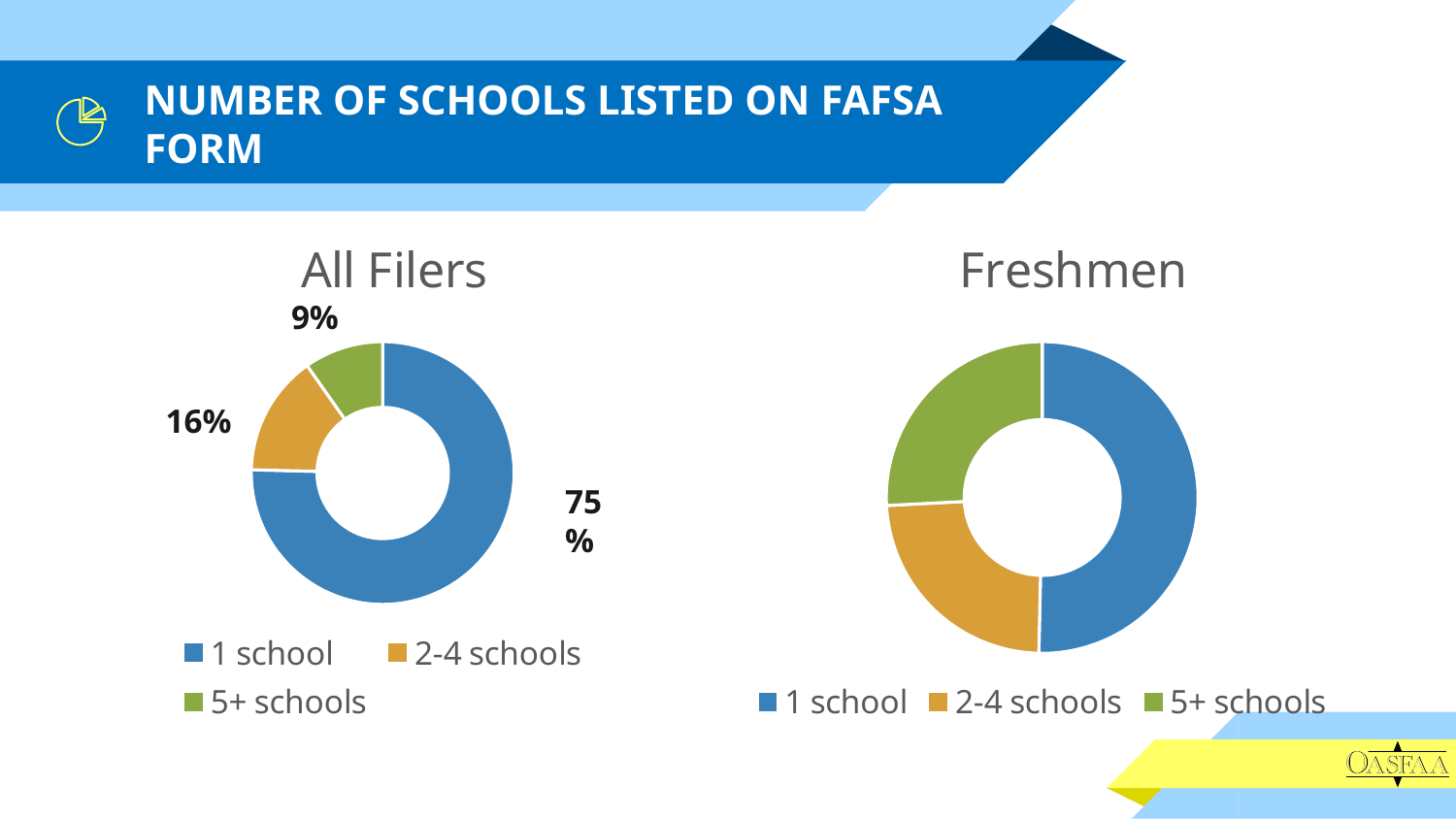
In the All Filers chart, which is larger: the share for 2-4 schools or the share for 5+ schools? 2-4 schools In the Freshmen chart, which category has the largest share? 1 school In the All Filers chart, what share of filers listed 5+ schools? 9% In the All Filers chart, what share of filers listed 1 school? 75% In the All Filers chart, which category has the largest share? 1 school In the All Filers chart, which category has the smallest share? 5+ schools What kind of chart is the Freshmen chart? Doughnut (pie) chart In the All Filers chart, what is the difference in percentage points between the 1 school and 2-4 schools shares? 59 How many categories does the legend of the All Filers chart list? 3 In the All Filers chart, what share of filers listed 2-4 schools? 16%